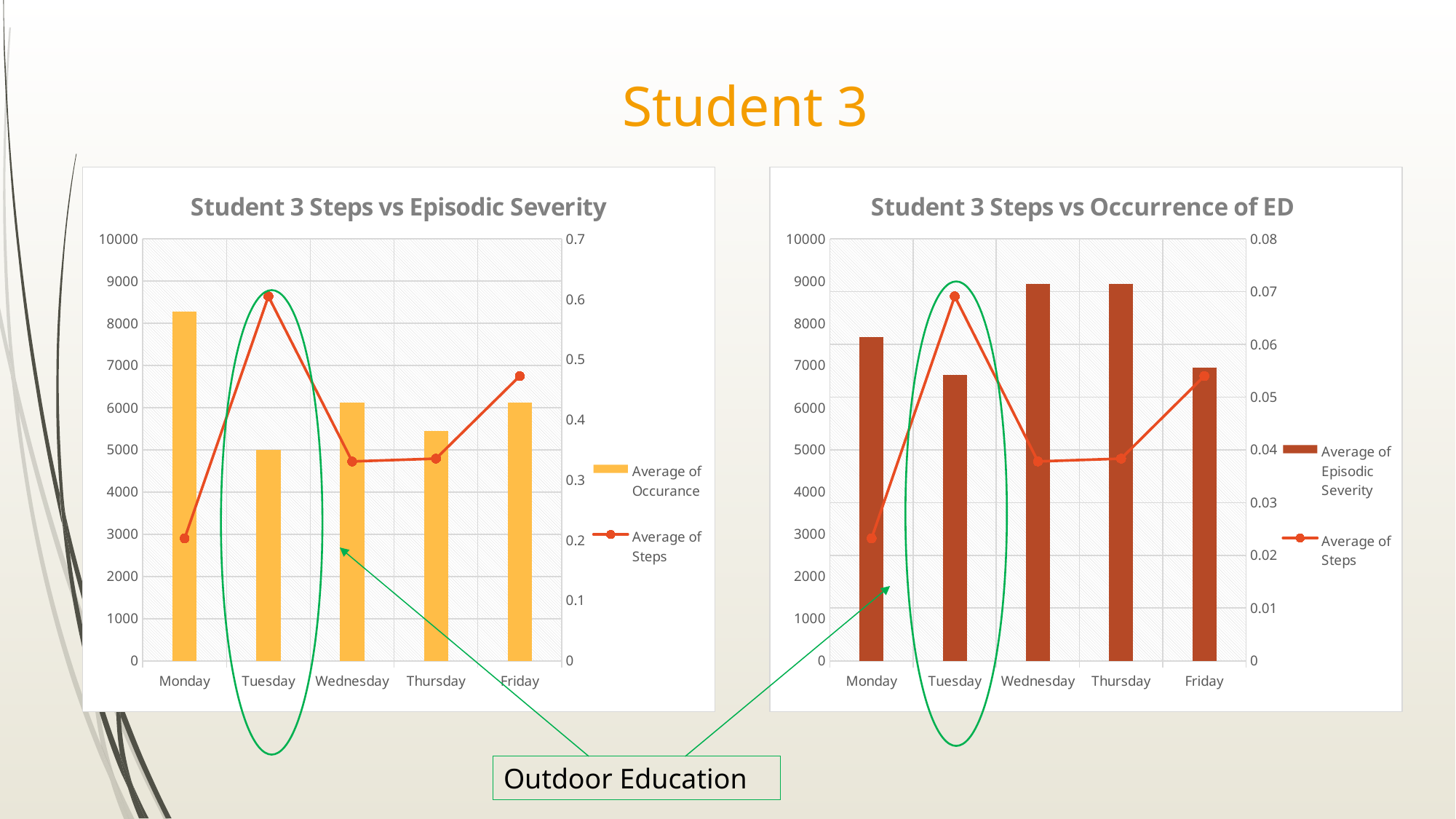
In the chart titled "Student 3 Steps vs Occurrence of ED", is the Average of Episodic Severity bar larger for Wednesday or Friday? Wednesday In the chart titled "Student 3 Steps vs Episodic Severity", which day has the lowest Average of Occurance bar? Tuesday In the chart titled "Student 3 Steps vs Occurrence of ED", how many days are shown on the x axis? 5 In the chart titled "Student 3 Steps vs Episodic Severity", on which day does the Average of Steps line reach its highest point? Tuesday In the chart titled "Student 3 Steps vs Episodic Severity", is the Average of Occurance bar larger for Monday or Tuesday? Monday In the chart titled "Student 3 Steps vs Episodic Severity", which day has the highest Average of Occurance bar? Monday In the chart titled "Student 3 Steps vs Occurrence of ED", how many series does the legend list? 2 In the chart titled "Student 3 Steps vs Occurrence of ED", on which day does the Average of Steps line reach its lowest point? Monday In the chart titled "Student 3 Steps vs Episodic Severity", does the Average of Steps line rise or fall from Wednesday to Friday? rise